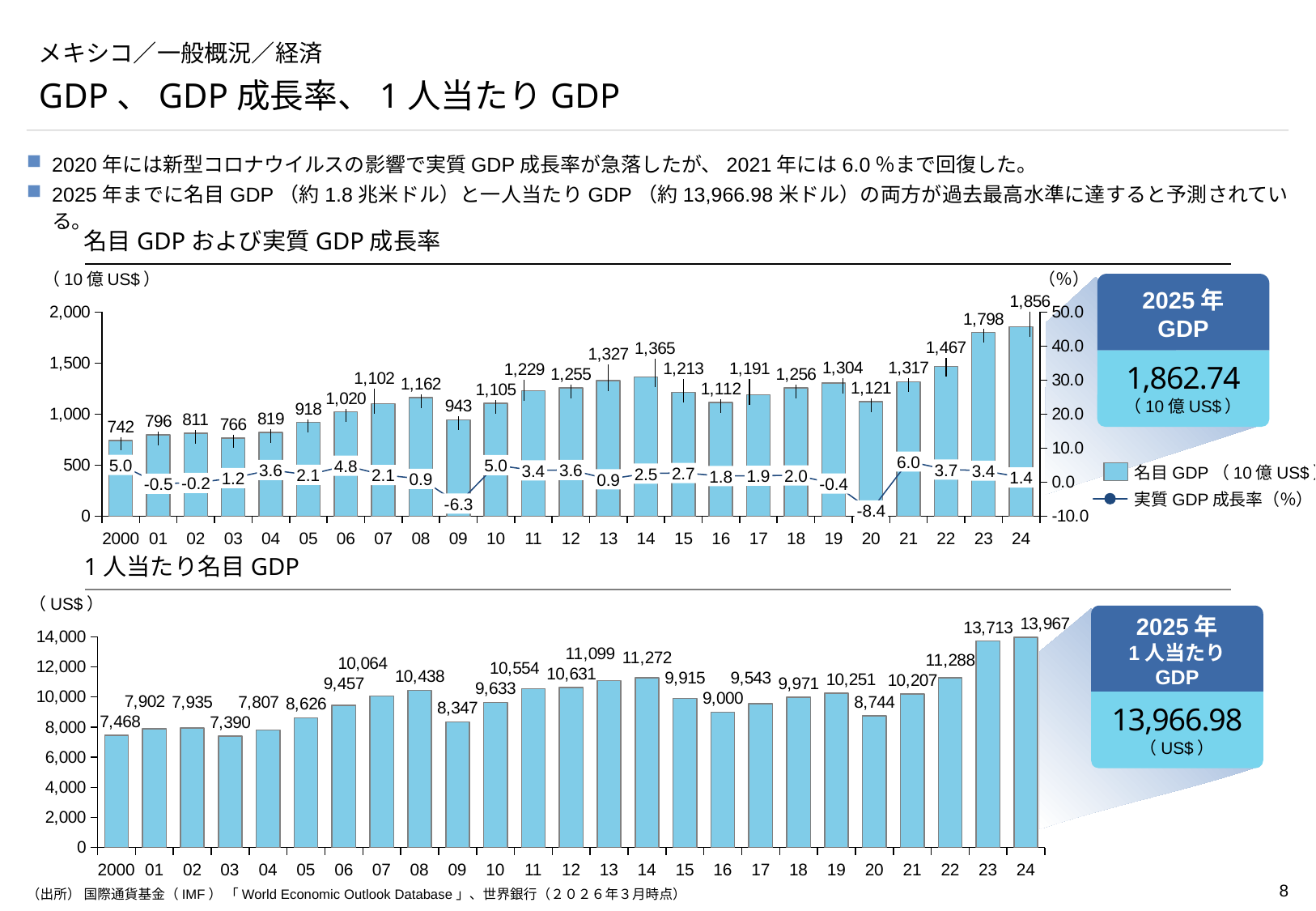
「名目GDPおよび実質GDP成長率」のグラフで、名目GDPが最も高い年はどれですか？ 24 「名目GDPおよび実質GDP成長率」のグラフで、2020年の実質GDP成長率は何％ですか？ -8.4 「名目GDPおよび実質GDP成長率」のグラフで、2009年の名目GDPはいくらですか？ 943 「1人当たり名目GDP」のグラフはどの種類のグラフですか？ 棒グラフ 「名目GDPおよび実質GDP成長率」のグラフで、2014年と2015年では、どちらの名目GDPが大きいですか？ 2014年 「1人当たり名目GDP」のグラフで、最も低い値の年はどれですか？ 03 「1人当たり名目GDP」のグラフで、2024年と2020年の差はいくらですか？ 5,223 「名目GDPおよび実質GDP成長率」のグラフの凡例には、いくつの系列がありますか？ 2 「名目GDPおよび実質GDP成長率」のグラフで、2024年と2023年の名目GDPの差はいくらですか？ 58 「名目GDPおよび実質GDP成長率」のグラフで、実質GDP成長率が最も低い年はどれですか？ 20 「1人当たり名目GDP」のグラフには、いくつの年（棒）が表示されていますか？ 25 「1人当たり名目GDP」のグラフで、2013年の値はいくらですか？ 11,099